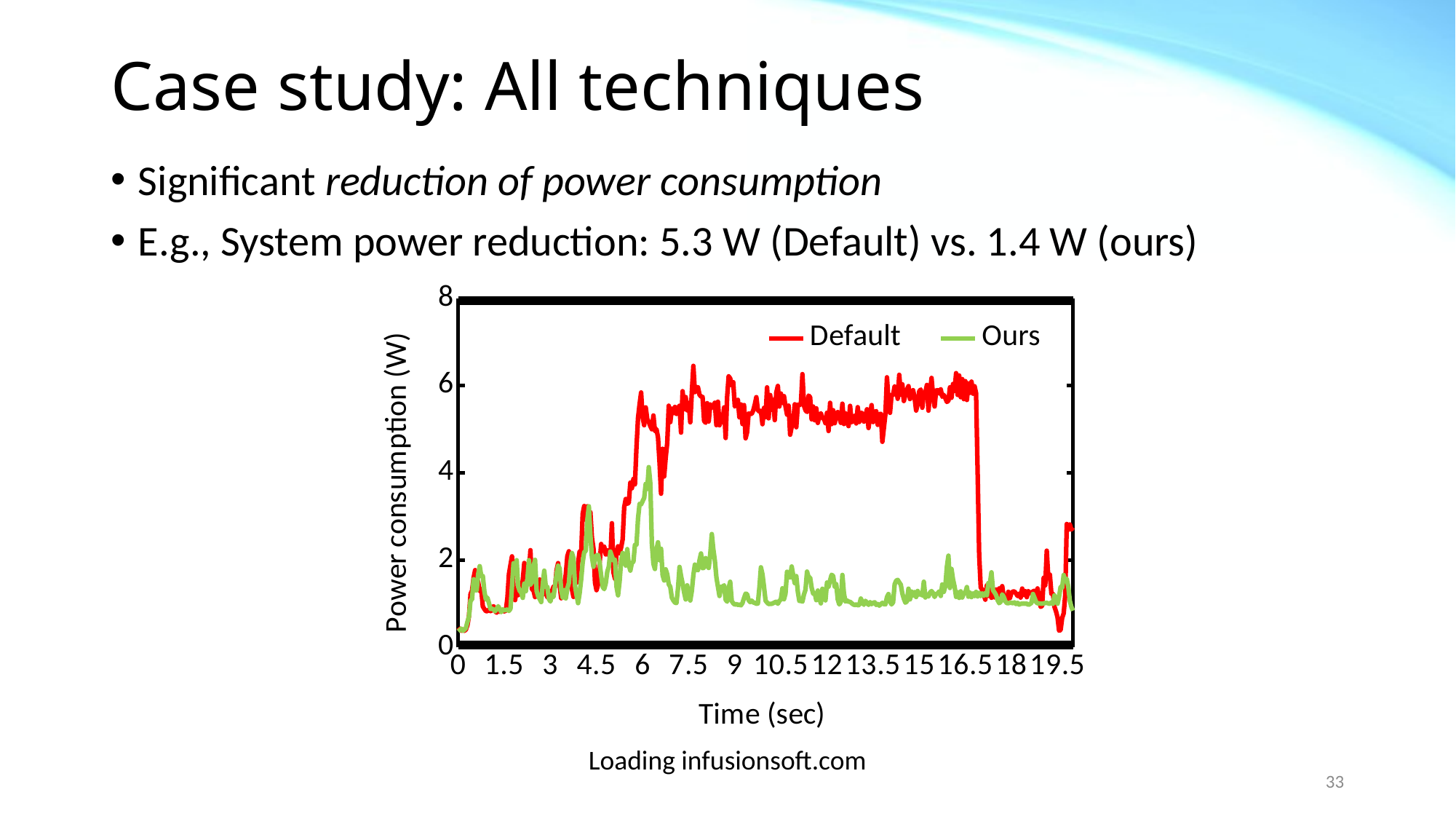
At 12 sec, which series has the higher power consumption, Default or Ours? Default Is the value of the Default series at 12 sec greater or less than 4? greater Is the value of the Default series at 9 sec greater or less than 4? greater How many tick labels are shown on the chart's x axis? 14 What are the two series named in the chart legend? Default and Ours What is the label of the chart's y axis? Power consumption (W) Is the value of the Ours series at 15 sec greater or less than 2? less What kind of chart is shown on the slide? line chart How many series does the chart legend list? 2 Does the Default series rise or fall between 16.5 sec and 18 sec? fall